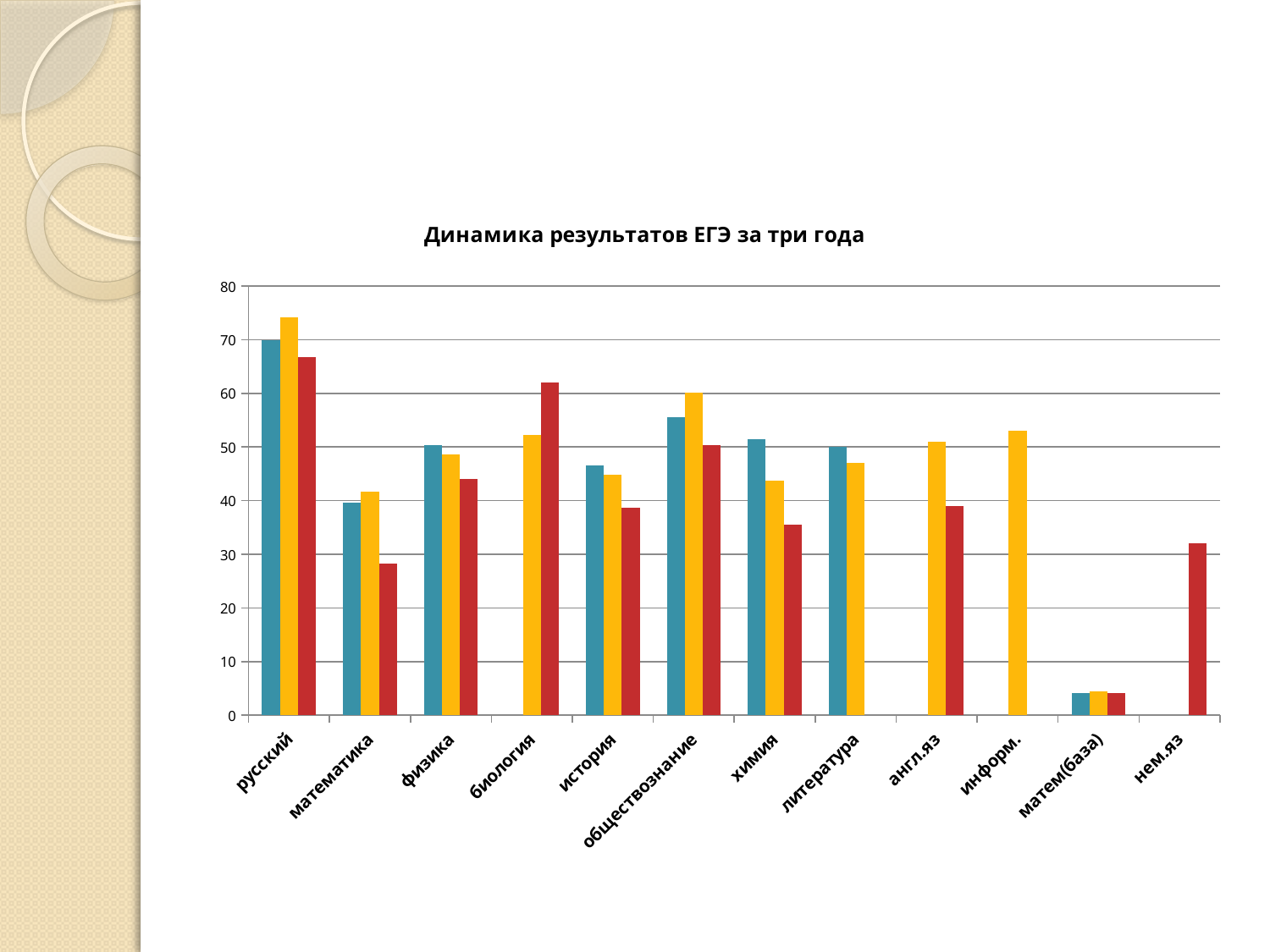
Which category has the lowest bars overall? матем(база) For химия, which is taller: the blue bar or the red bar? blue Is the red bar for математика greater or less than 30? less What is the title of the chart? Динамика результатов ЕГЭ за три года For русский, which is taller: the blue bar or the yellow bar? yellow Is the yellow bar for обществознание greater or less than 50? greater What kind of chart is shown on the slide? bar chart Which category has the tallest yellow bar? русский How many subject categories are shown on the x axis? 12 How many differently coloured bar series are plotted in the chart? 3 Is the blue bar for русский greater or less than 60? greater